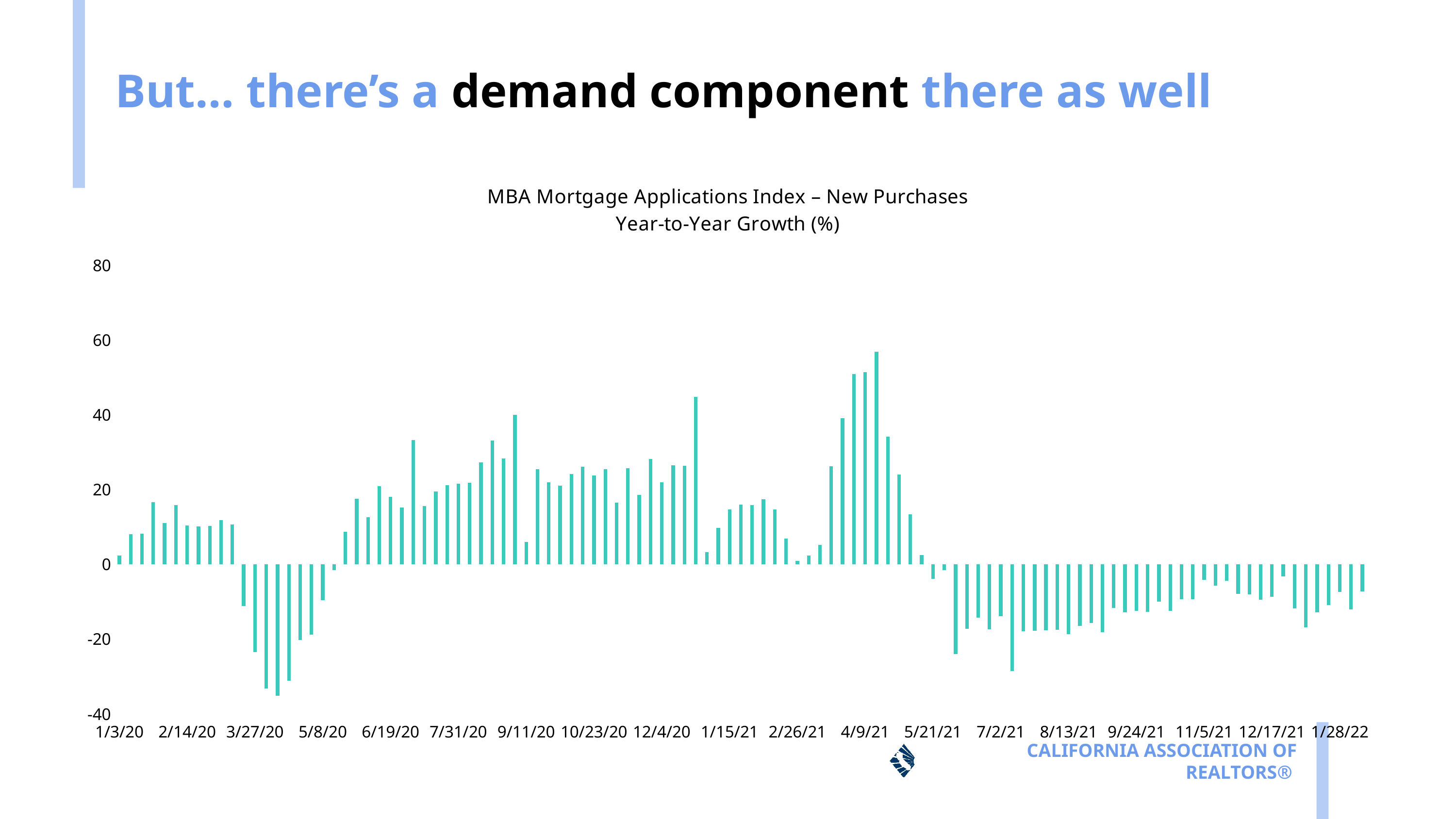
Is the value for 2/14/20 greater or less than 0? greater Is the value for 3/27/20 greater or less than 0? less Which is larger, the value for 4/9/21 or the value for 7/2/21? 4/9/21 What is the title of the chart? MBA Mortgage Applications Index – New Purchases Year-to-Year Growth (%) What is the highest value shown on the vertical axis? 80 Is the lowest value in the chart greater or less than -20? less What kind of chart is shown on the slide? bar chart Do the values generally rise or fall between 4/9/21 and 7/2/21? fall